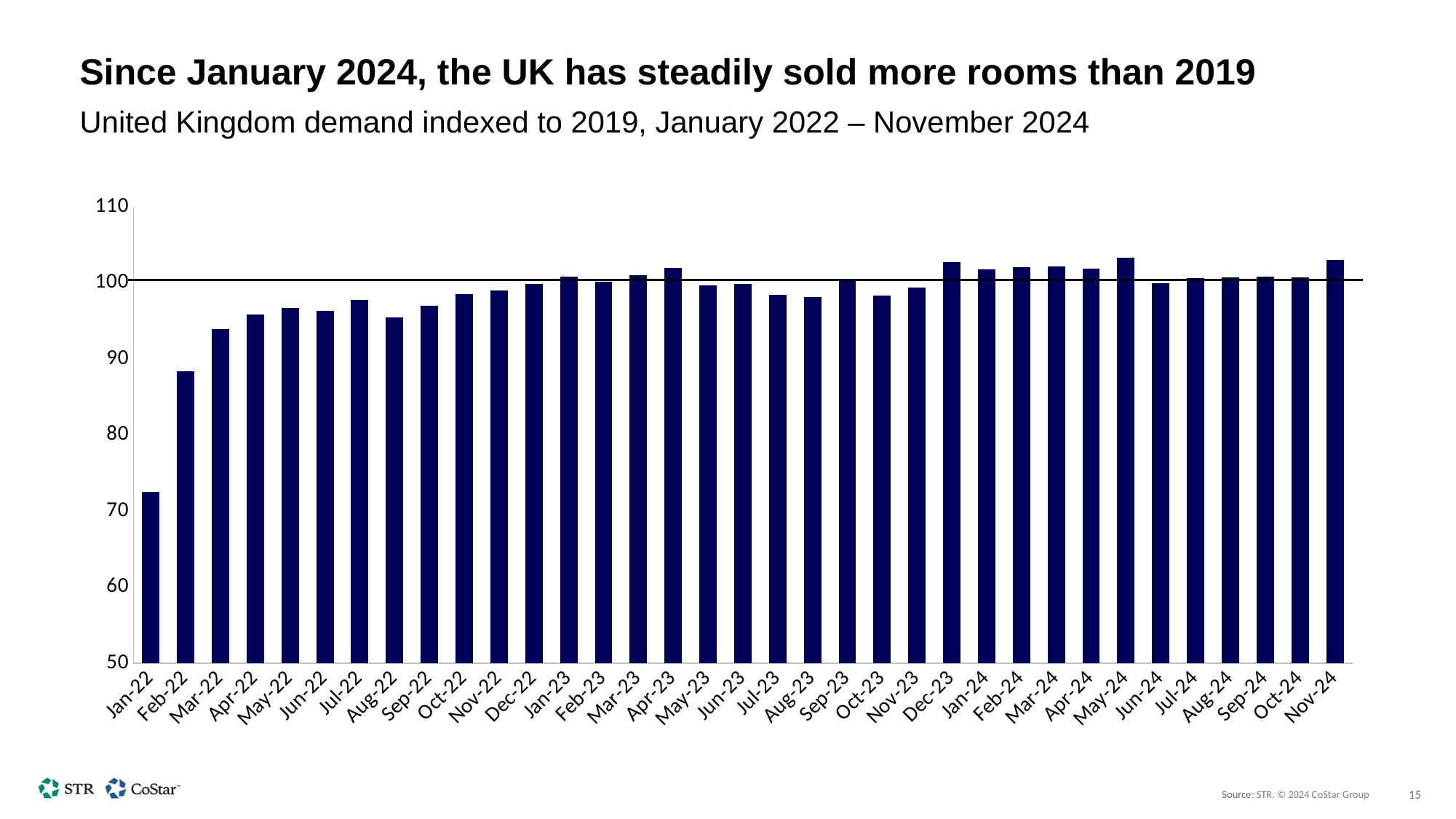
What is the subtitle describing the chart's data? United Kingdom demand indexed to 2019, January 2022 – November 2024 How many monthly bars are plotted in the chart? 35 Is the value for May-24 greater or less than 100? greater Which is larger, the value for Nov-23 or the value for Dec-23? Dec-23 Overall, do the values rise or fall from Jan-22 to Nov-24? Rise What kind of chart is shown on the slide? Bar chart Is the value for Oct-23 greater or less than 100? less Is the value for Feb-22 greater or less than 90? less Which month has the lowest value in the chart? Jan-22 Which is larger, the value for Jan-22 or the value for Feb-22? Feb-22